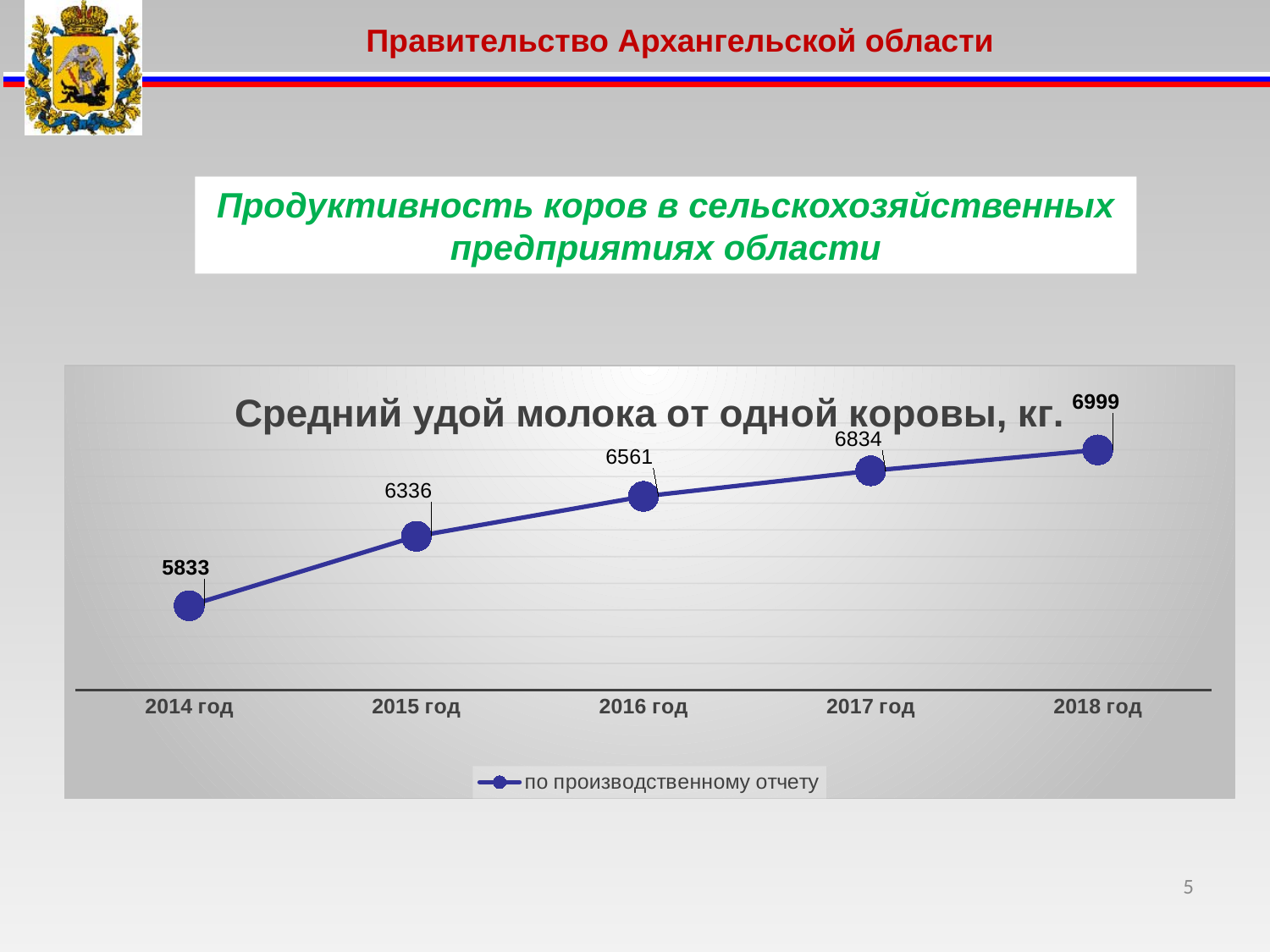
Which year has the lowest average milk yield per cow? 2014 год What is the average milk yield per cow in 2018 год? 6999 Which year has the highest average milk yield per cow? 2018 год What is the difference between the milk yield in 2018 год and 2014 год? 1166 What is the difference between the milk yield in 2017 год and 2016 год? 273 What kind of chart is shown on the slide? line chart How many years are plotted on the chart? 5 What is the average milk yield per cow in 2016 год? 6561 Which year has a higher milk yield, 2015 год or 2017 год? 2017 год Do the milk yield values rise or fall from 2014 год to 2018 год? rise How many series does the legend list? 1 What is the average milk yield per cow in 2014 год? 5833